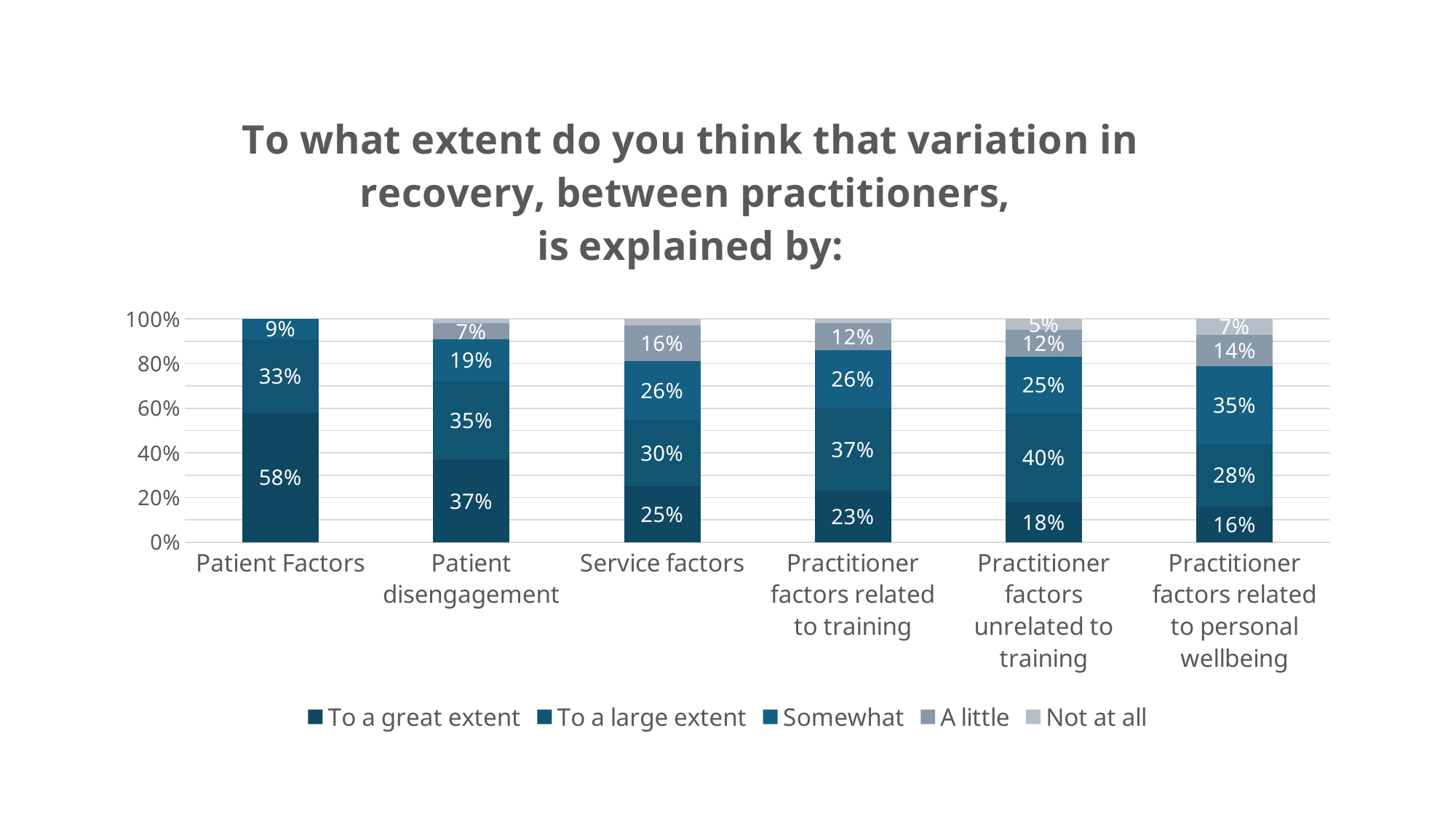
Which category has the highest "To a great extent" value? Patient Factors Which category has the lowest "To a great extent" value? Practitioner factors related to personal wellbeing Which has the larger "To a large extent" value: Service factors or Practitioner factors unrelated to training? Practitioner factors unrelated to training What is the "A little" value for Service factors? 16% What is the "Somewhat" value for Practitioner factors related to personal wellbeing? 35% How many series does the legend list? 5 What is the first entry in the chart's legend? To a great extent What percentage of respondents answered "To a great extent" for Patient Factors? 58% What is the "Not at all" value for Practitioner factors unrelated to training? 5% How many categories are shown on the x axis? 6 What kind of chart is shown on the slide? Stacked bar chart How many percentage points higher is the "To a great extent" value for Patient Factors than for Patient disengagement? 21